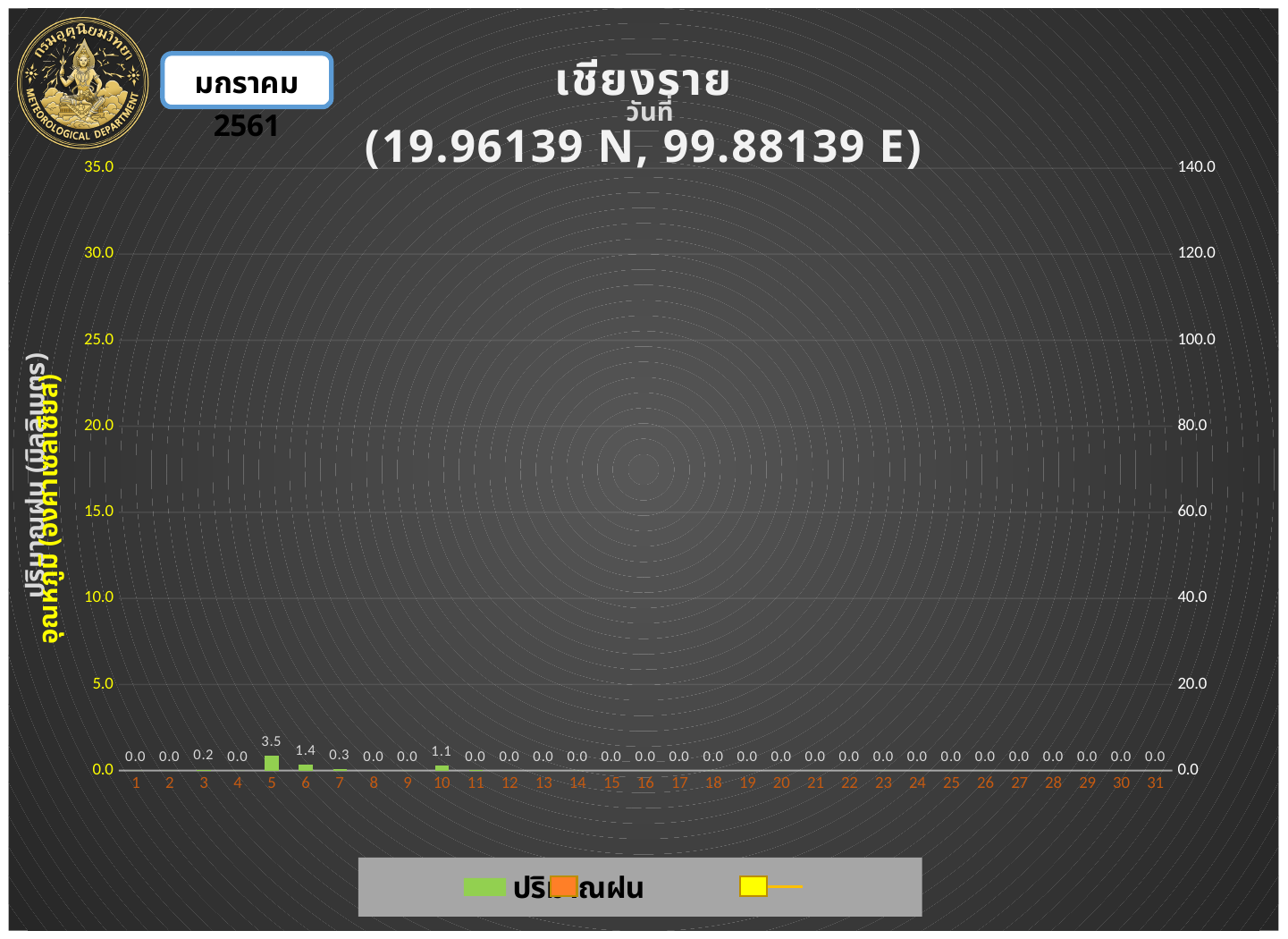
What is the rainfall value for day 10? 1.1 What is the difference between the rainfall values for day 5 and day 6? 2.1 What is the rainfall value for day 7? 0.3 How many days are shown on the x axis? 31 What is the rainfall value for day 5? 3.5 What is the rainfall value for day 3? 0.2 What is the maximum value shown on the left y axis? 35.0 Which is larger, the rainfall value for day 6 or for day 10? day 6 What is the rainfall value for day 6? 1.4 Which day has the highest rainfall value? 5 Is the rainfall value for day 5 greater or less than 5.0? less What kind of chart is used to show the rainfall values? bar chart